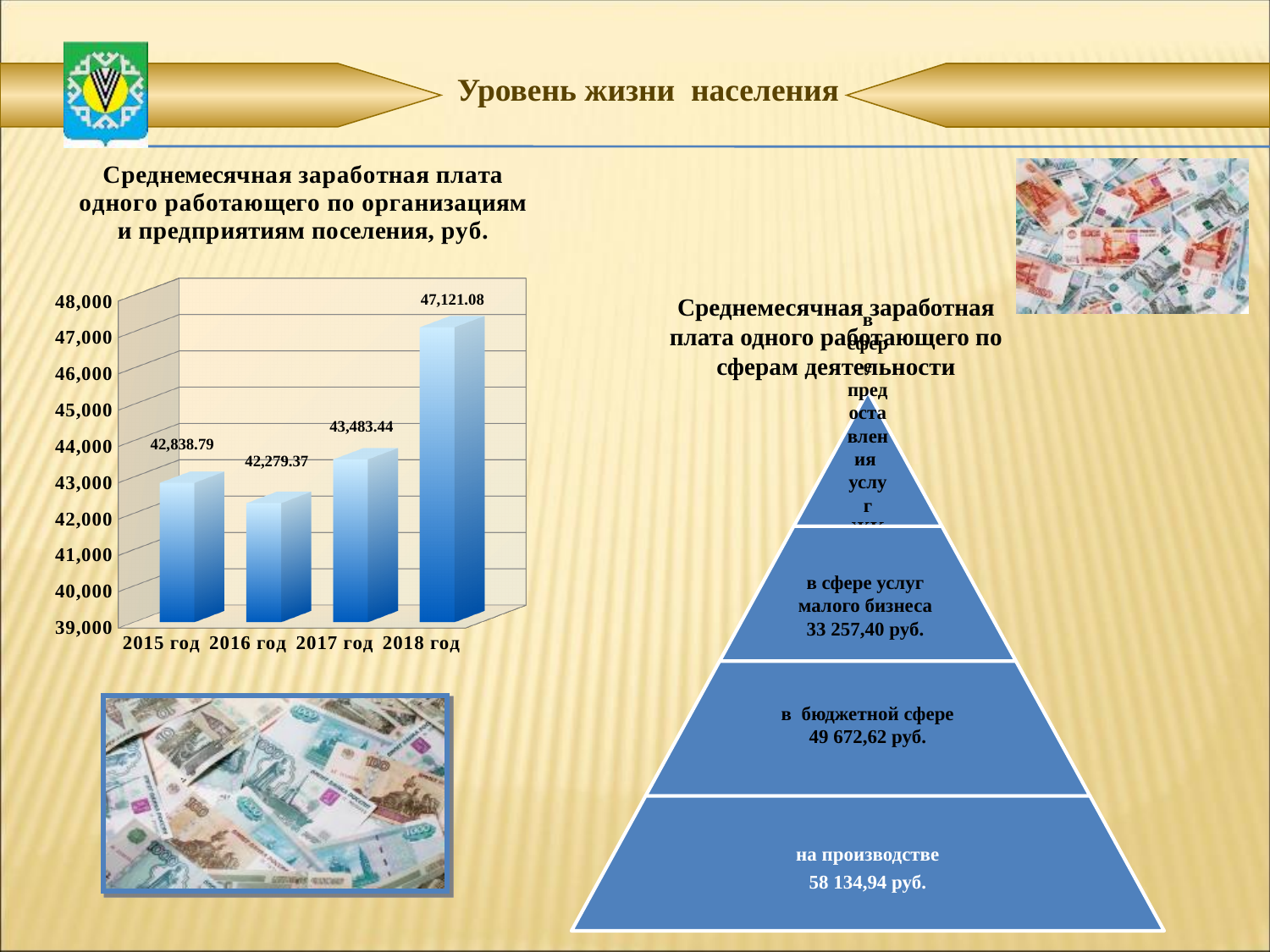
On the bar chart on the left, is the value for 2017 год greater or less than 44,000? less On the pyramid diagram on the right, what is the average monthly salary в бюджетной сфере? 49 672,62 руб. How many years are shown on the bar chart on the left? 4 On the bar chart on the left, which is larger: the value for 2015 год or 2016 год? 2015 год On the pyramid diagram on the right, what is the average monthly salary на производстве? 58 134,94 руб. What type of chart is shown on the left of the slide? bar chart On the bar chart on the left, what is the value shown for 2015 год? 42,838.79 On the bar chart on the left, which year has the lowest value? 2016 год On the bar chart on the left, what is the difference between the values for 2018 год and 2017 год? 3,637.64 On the bar chart on the left, what is the value shown for 2016 год? 42,279.37 On the bar chart on the left, which year has the highest value? 2018 год On the bar chart on the left, what is the average monthly salary for 2018 год? 47,121.08